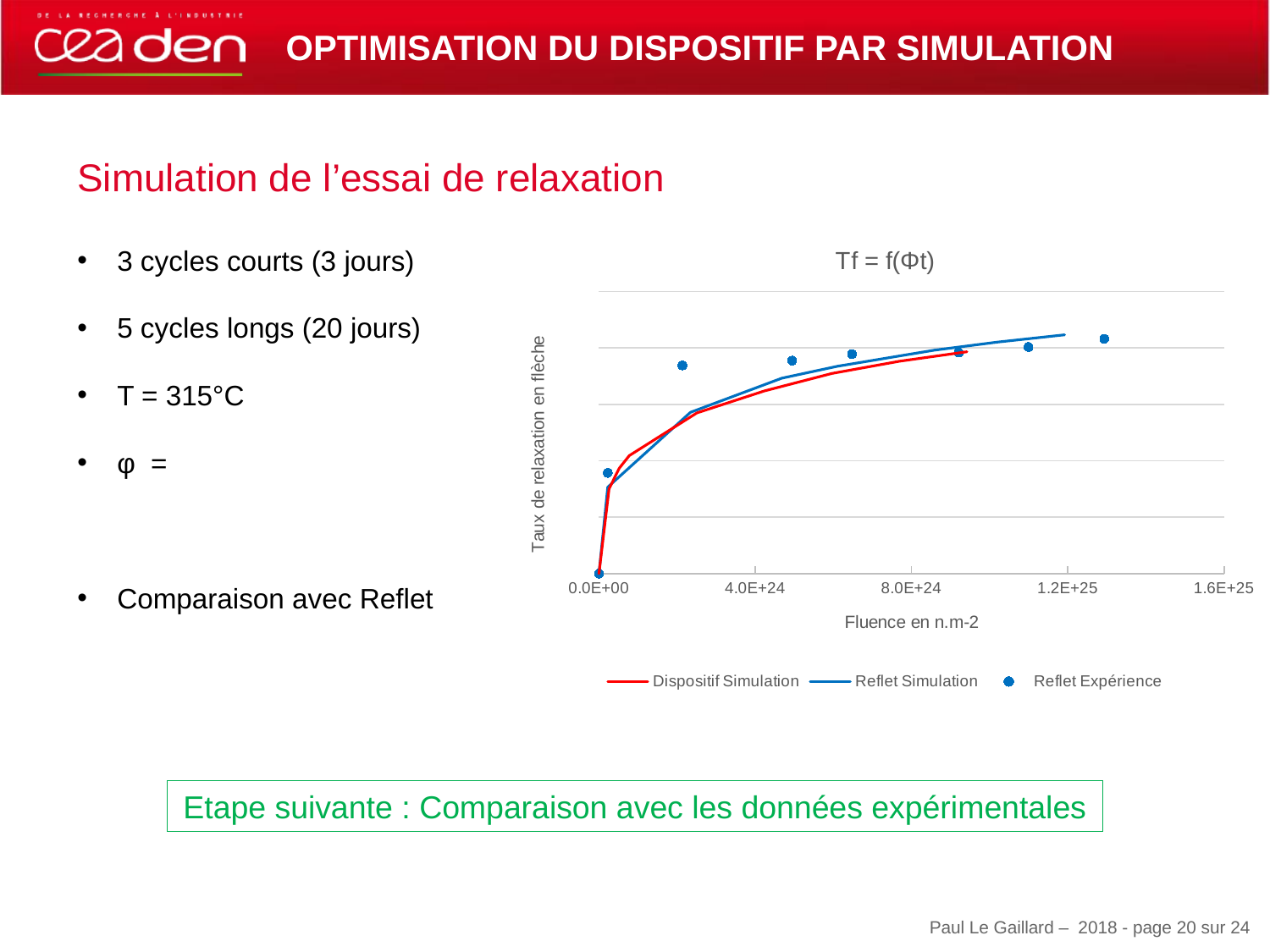
What is the title of the chart? Tf = f(Φt) Which series extends to a higher fluence, Reflet Simulation or Dispositif Simulation? Reflet Simulation Is the fluence of the rightmost Reflet Expérience point greater or less than 1.2E+25? greater How many tick labels are shown on the x axis of the chart? 5 Do the Reflet Expérience points rise or fall as fluence increases along the x axis? rise Do the values of the Dispositif Simulation series rise or fall as fluence increases along the x axis? rise How many series does the chart legend list? 3 Is the fluence at which the Dispositif Simulation line ends greater or less than 1.2E+25? less What kind of chart is shown on the slide? line chart What is the label of the x axis of the chart? Fluence en n.m-2 Which series is drawn as a red line in the chart? Dispositif Simulation What is the highest fluence value shown on the x axis? 1.6E+25